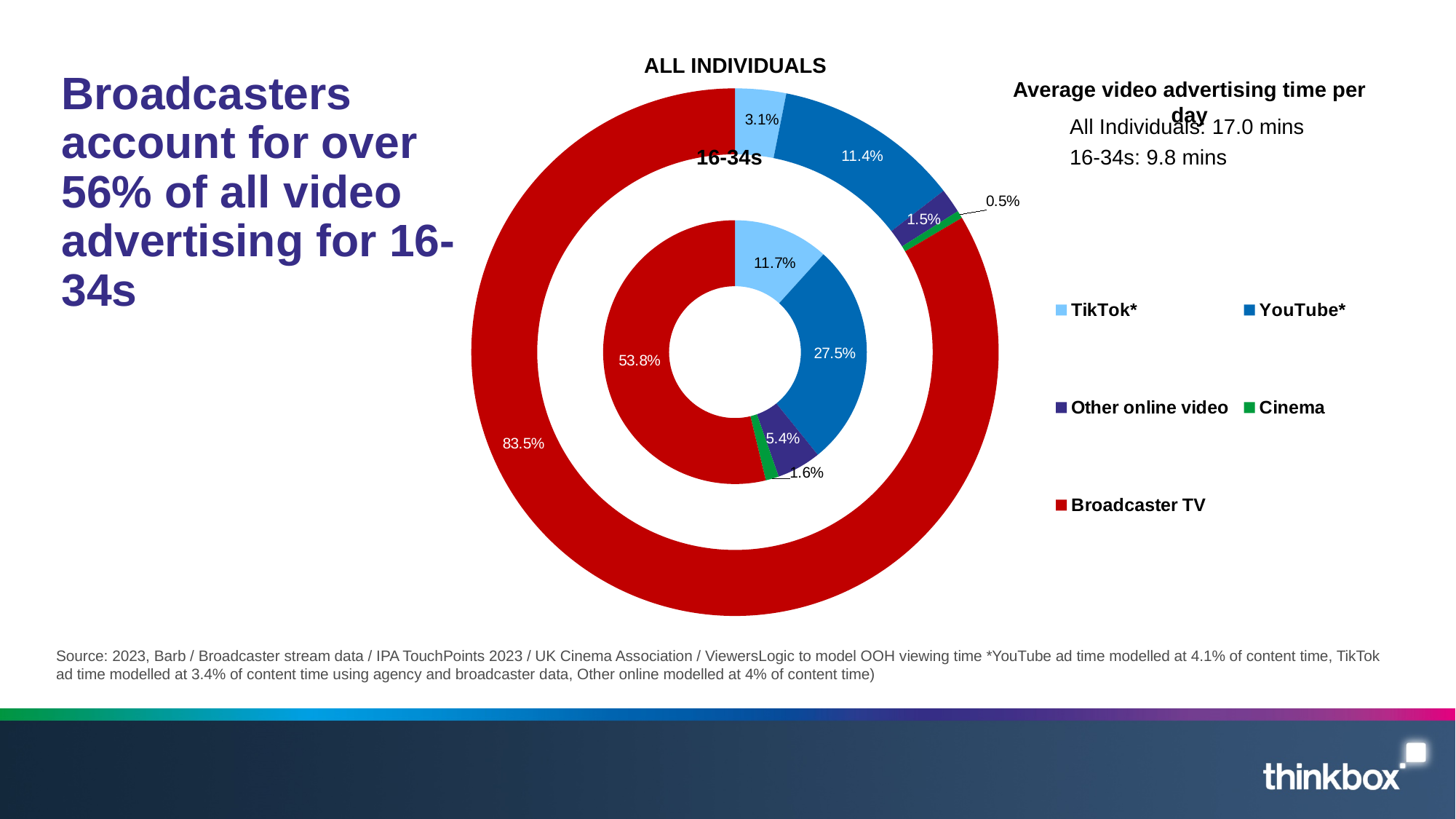
According to the text box, what is the average video advertising time per day for 16-34s? 9.8 mins In the 16-34s ring, what is the value for Cinema? 1.6% What kind of chart is shown on the slide? Doughnut chart How many categories does the legend list? 5 In the 16-34s ring, what is the value for YouTube*? 27.5% Is the Other online video share larger for 16-34s or for ALL INDIVIDUALS? 16-34s Which category has the largest share in the 16-34s ring? Broadcaster TV Which category has the smallest share in the ALL INDIVIDUALS ring? Cinema In the ALL INDIVIDUALS ring, what share does Broadcaster TV account for? 83.5% In the 16-34s ring, what share does Broadcaster TV account for? 53.8% In the ALL INDIVIDUALS ring, what is the value for TikTok*? 3.1% What is the difference between the TikTok* share for 16-34s and for ALL INDIVIDUALS? 8.6 percentage points